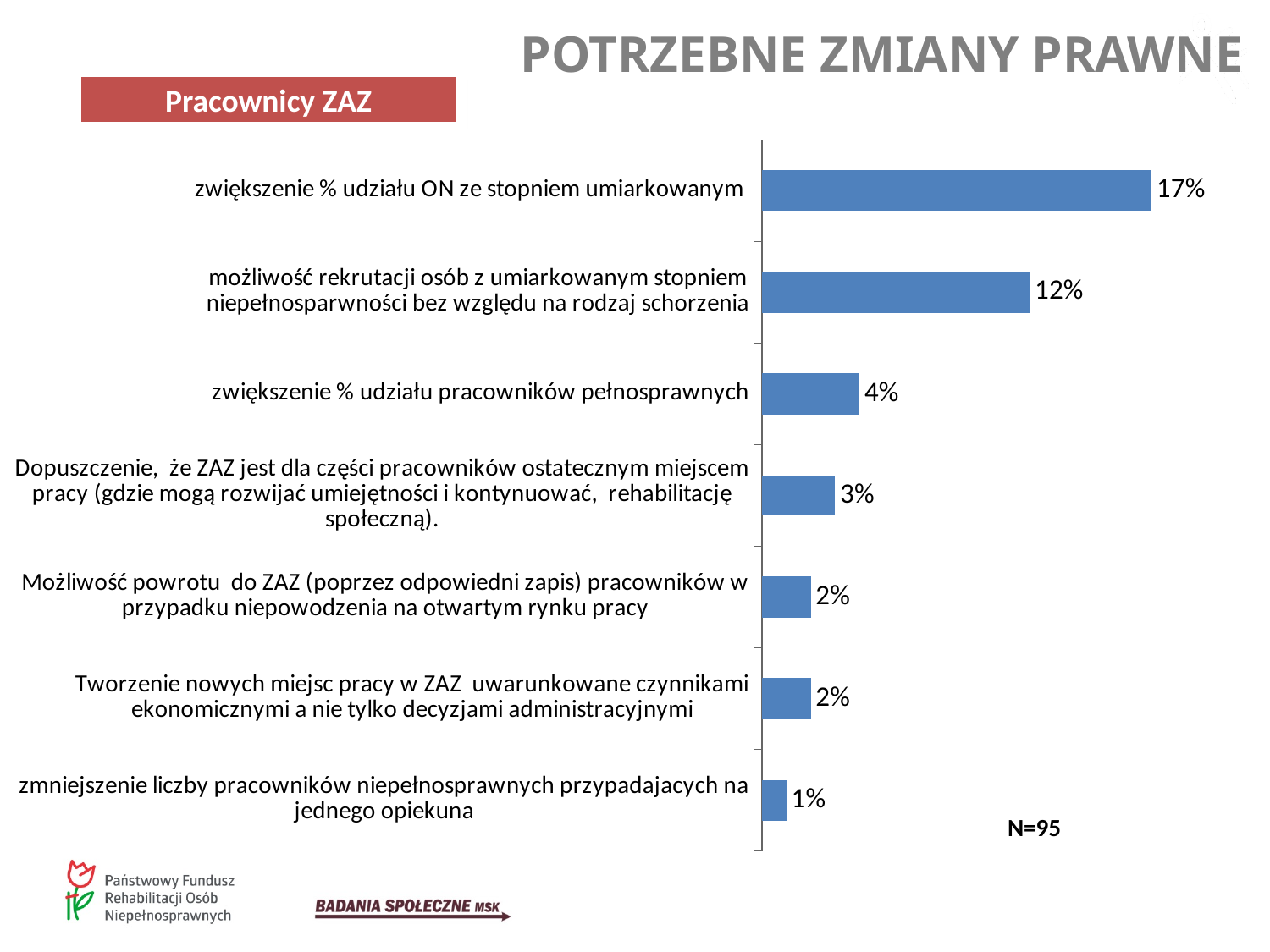
What is the value for "zwiększenie % udziału ON ze stopniem umiarkowanym"? 17% Which category has the lowest value? zmniejszenie liczby pracowników niepełnosprawnych przypadajacych na jednego opiekuna Which category has the highest value? zwiększenie % udziału ON ze stopniem umiarkowanym What kind of chart is shown on the slide? bar chart How many categories are shown in the chart? 7 What is the value for "możliwość rekrutacji osób z umiarkowanym stopniem niepełnosparwności bez względu na rodzaj schorzenia"? 12% Which is larger: the value for "zwiększenie % udziału pracowników pełnosprawnych" or the value for "Dopuszczenie, że ZAZ jest dla części pracowników ostatecznym miejscem pracy"? zwiększenie % udziału pracowników pełnosprawnych What is the value for "zmniejszenie liczby pracowników niepełnosprawnych przypadajacych na jednego opiekuna"? 1% What is the value for "zwiększenie % udziału pracowników pełnosprawnych"? 4% What is the label in the red box above the chart? Pracownicy ZAZ What is the sample size (N) shown on the chart? N=95 What is the difference between the values for "zwiększenie % udziału ON ze stopniem umiarkowanym" and "możliwość rekrutacji osób z umiarkowanym stopniem niepełnosparwności bez względu na rodzaj schorzenia"? 5%